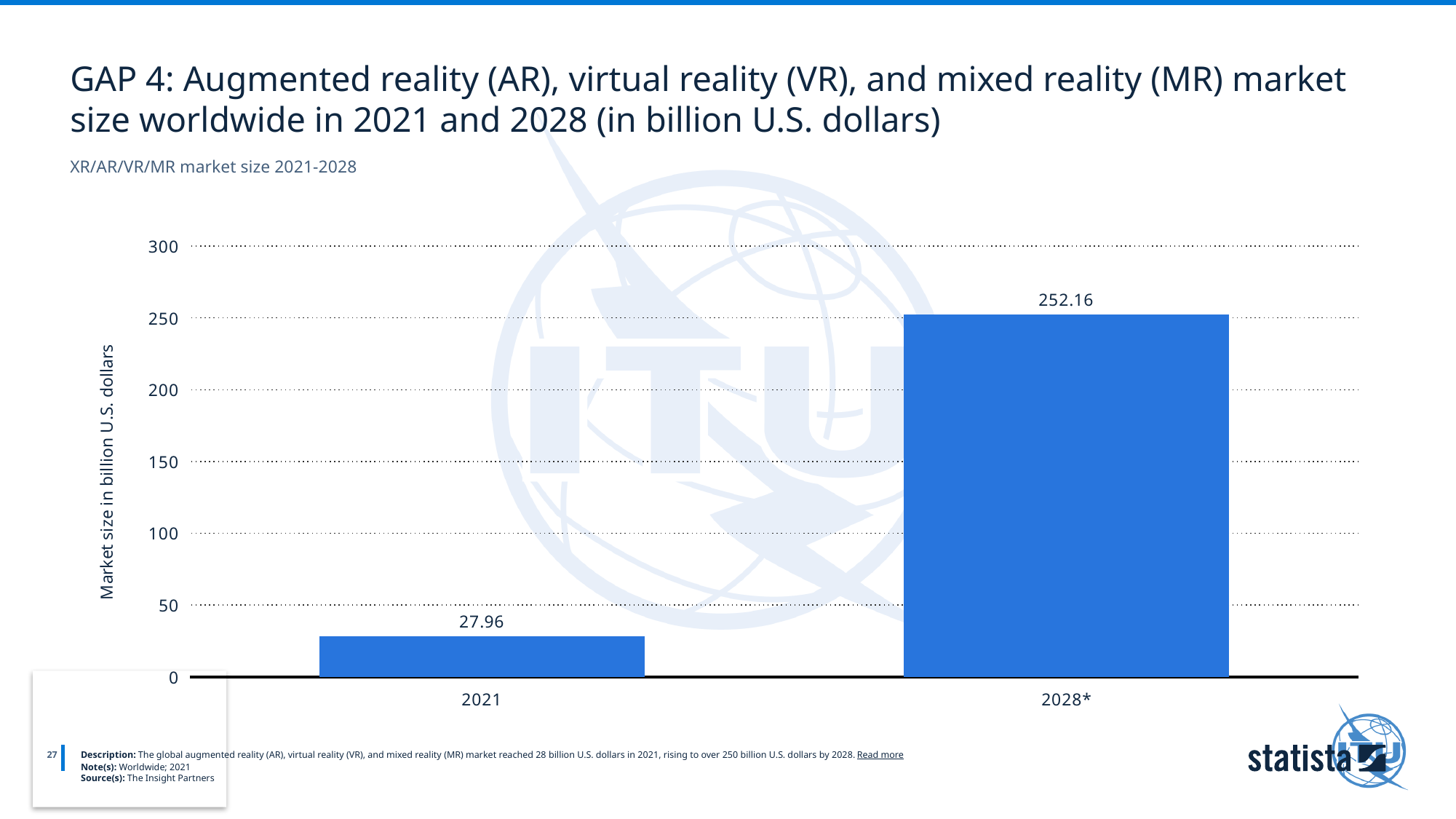
Is the value for 2021 larger or smaller than the value for 2028*? smaller What is the market size shown for 2021? 27.96 Is the value for 2028* greater or less than 250? greater What is the market size shown for 2028*? 252.16 What kind of chart is shown on the slide? bar chart What is the difference between the 2028* and 2021 market sizes? 224.2 Which year has the lower market size? 2021 How many bars are plotted in the chart? 2 Is the value for 2021 greater or less than 50? less What is the label of the vertical axis? Market size in billion U.S. dollars Which year has the higher market size? 2028* Do the values rise or fall from 2021 to 2028*? rise